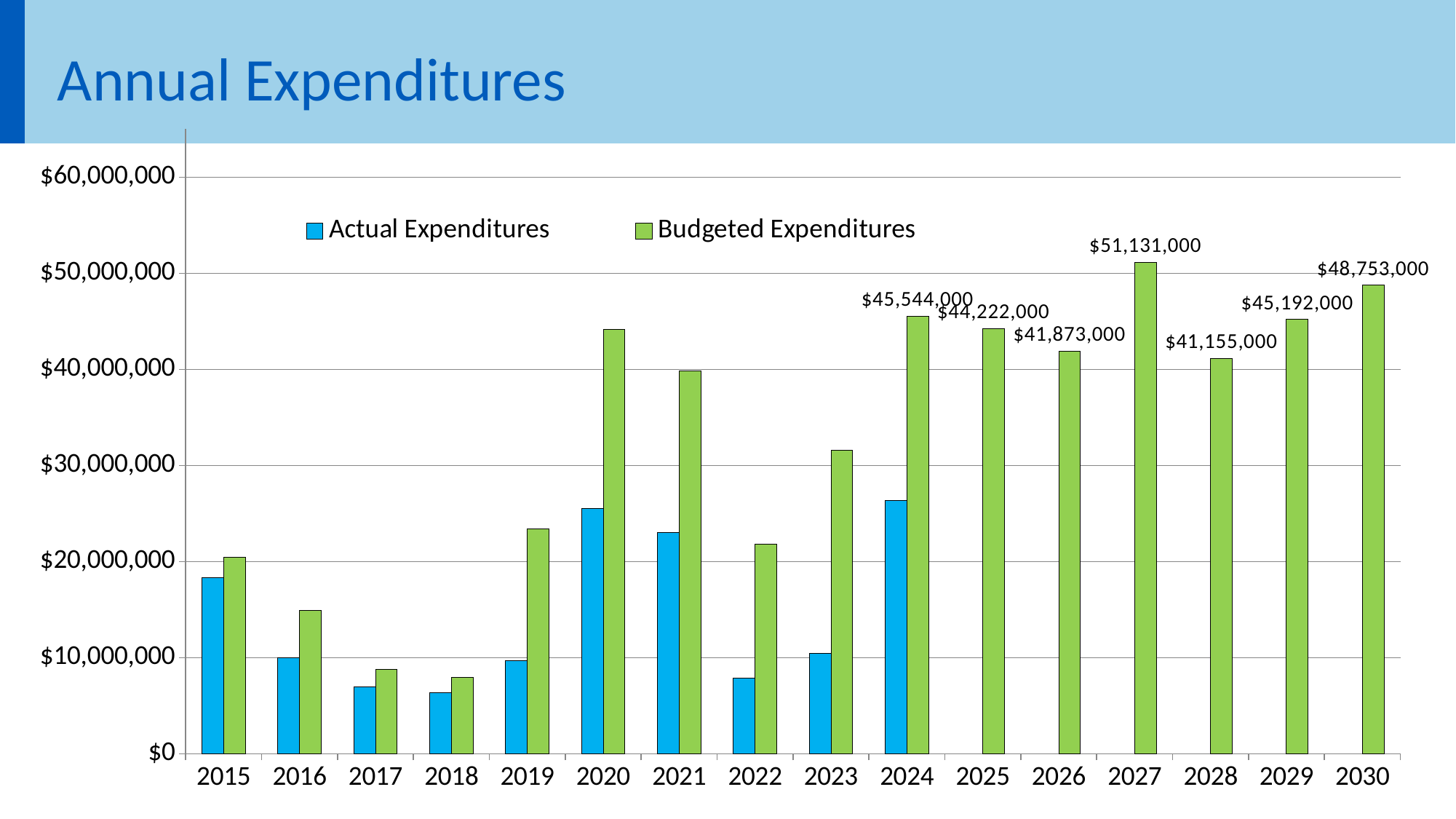
Which year has larger Budgeted Expenditures, 2026 or 2029? 2029 Is the Actual Expenditures value for 2020 greater or less than $20,000,000? greater How many years are shown on the x axis? 16 Is the Actual Expenditures value for 2018 greater or less than $10,000,000? less What is the difference between the Budgeted Expenditures for 2027 and 2028? $9,976,000 What is the Budgeted Expenditures value for 2027? $51,131,000 How many series does the legend list? 2 What is the Budgeted Expenditures value for 2028? $41,155,000 What kind of chart is shown on the slide? Bar chart What is the difference between the Budgeted Expenditures for 2030 and 2029? $3,561,000 Which year has the highest Budgeted Expenditures? 2027 What is the Budgeted Expenditures value for 2030? $48,753,000